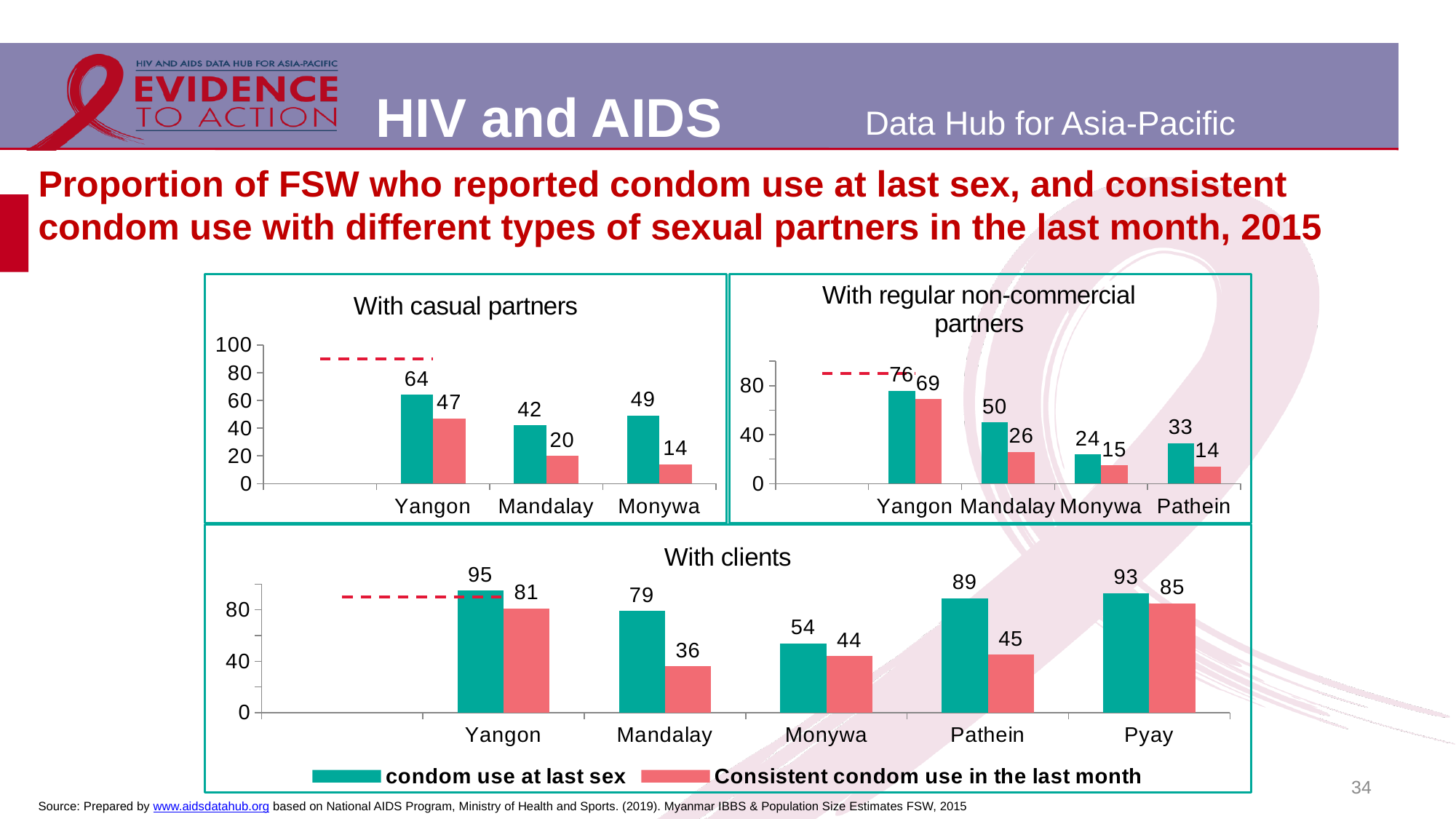
In the 'With regular non-commercial partners' chart, what is the difference between condom use at last sex and consistent condom use in the last month in Mandalay? 24 In the 'With clients' chart, which city has the lowest value for condom use at last sex? Monywa In the 'With casual partners' chart, what is the difference between condom use at last sex and consistent condom use in the last month in Yangon? 17 In the 'With clients' chart, what is the value for consistent condom use in the last month in Pyay? 85 In the 'With regular non-commercial partners' chart, which city has the highest value for condom use at last sex? Yangon In the 'With clients' chart, is consistent condom use in the last month higher in Pathein or in Monywa? Pathein In the 'With casual partners' chart, what is the value for condom use at last sex in Yangon? 64 What type of chart is the 'With casual partners' chart? Bar chart How many cities are shown on the x axis of the 'With clients' chart? 5 In the 'With casual partners' chart, what is the value for consistent condom use in the last month in Monywa? 14 How many series does the legend list? 2 Which colour represents consistent condom use in the last month in the legend? Red (pink)